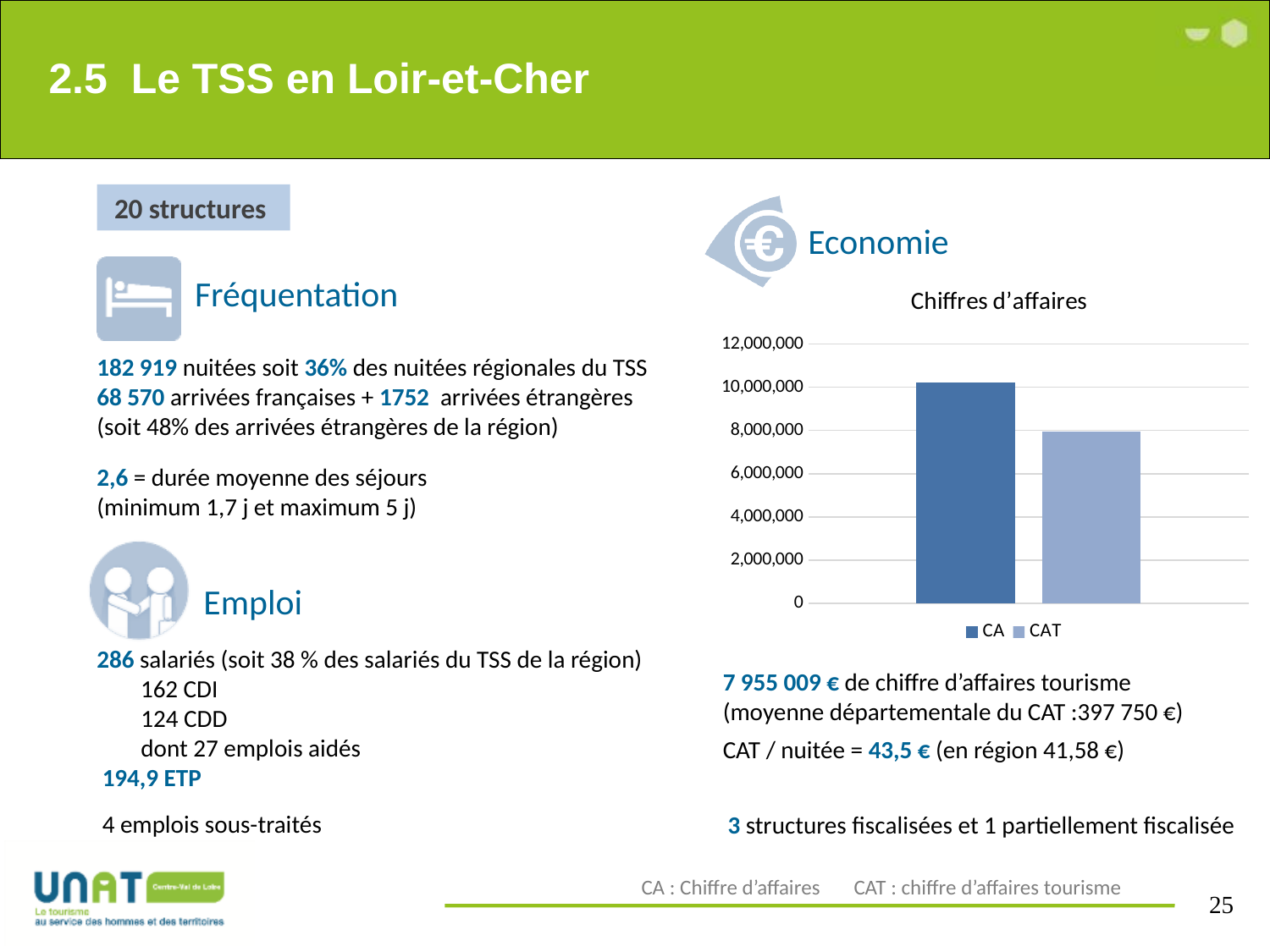
What are the two entries in the legend of the "Chiffres d'affaires" chart? CA and CAT How many bars are plotted in the "Chiffres d'affaires" chart? 2 In the "Chiffres d'affaires" chart, is the value for CA greater or less than 12,000,000? less In the "Chiffres d'affaires" chart, which series has the highest value? CA In the "Chiffres d'affaires" chart, which is larger, CA or CAT? CA In the "Chiffres d'affaires" chart, which series has the lowest value? CAT How many series does the legend of the "Chiffres d'affaires" chart list? 2 In the "Chiffres d'affaires" chart, is the value for CAT greater or less than 6,000,000? greater What kind of chart is shown under the title "Chiffres d'affaires"? bar chart What is the title of the chart on the slide? Chiffres d'affaires In the "Chiffres d'affaires" chart, is the value for CA greater or less than 8,000,000? greater